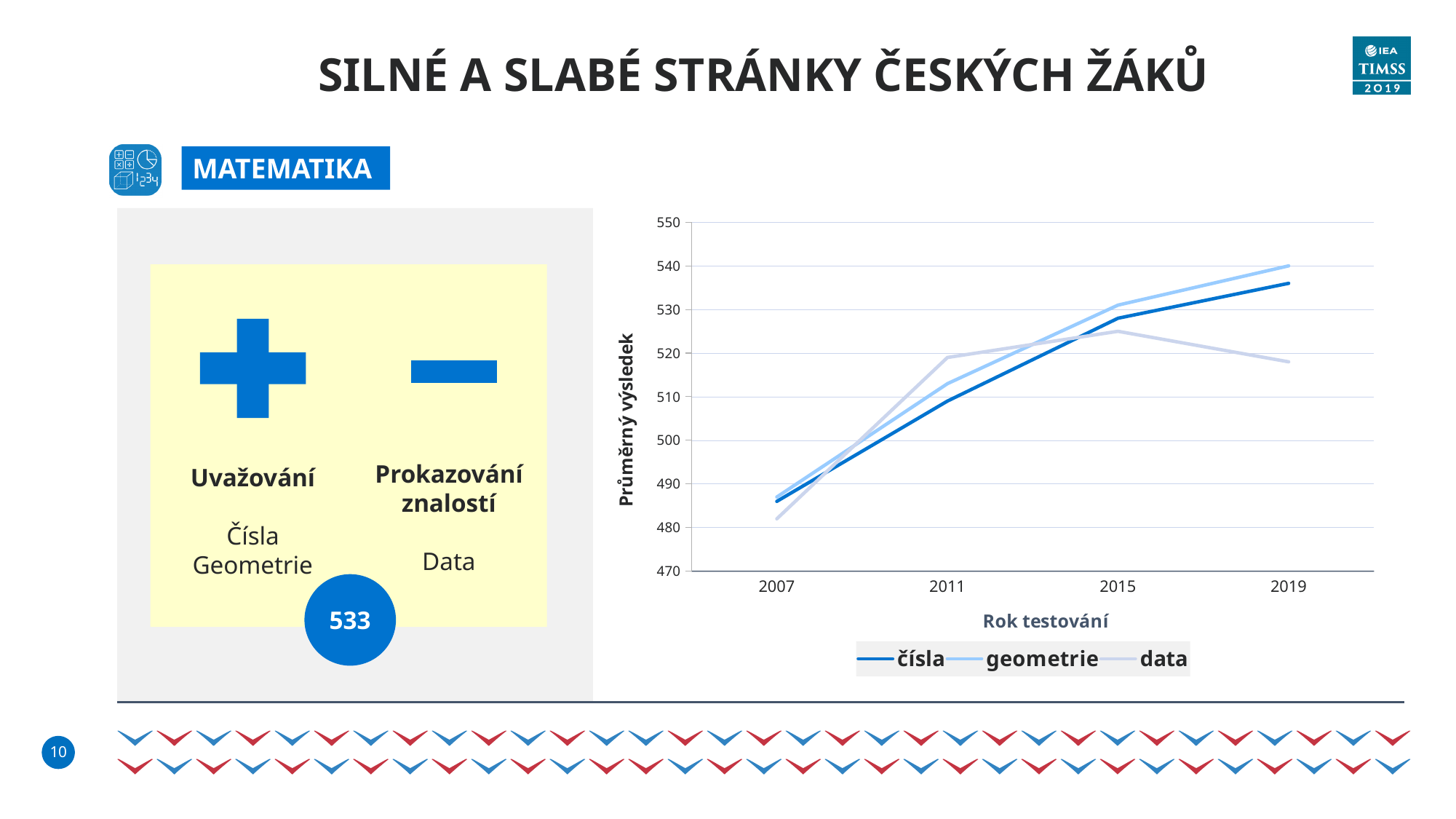
What kind of chart is shown on the right side of the slide? line chart How many test years are plotted on the x axis of the line chart? 4 Is the value for 'čísla' in 2019 greater or less than 530? greater What is the title of the y axis of the line chart? Průměrný výsledek Which series has the lowest value in 2019 in the line chart? data Is the value for 'data' in 2007 greater or less than 490? less Is the value for 'čísla' in 2011 greater or less than 500? greater Does the 'čísla' series rise or fall from 2007 to 2019? rise Which series has the highest value in 2019 in the line chart? geometrie In 2011, which is larger: the value for 'data' or the value for 'čísla'? data In which year does the 'data' series reach its highest value? 2015 How many series does the legend of the line chart list? 3